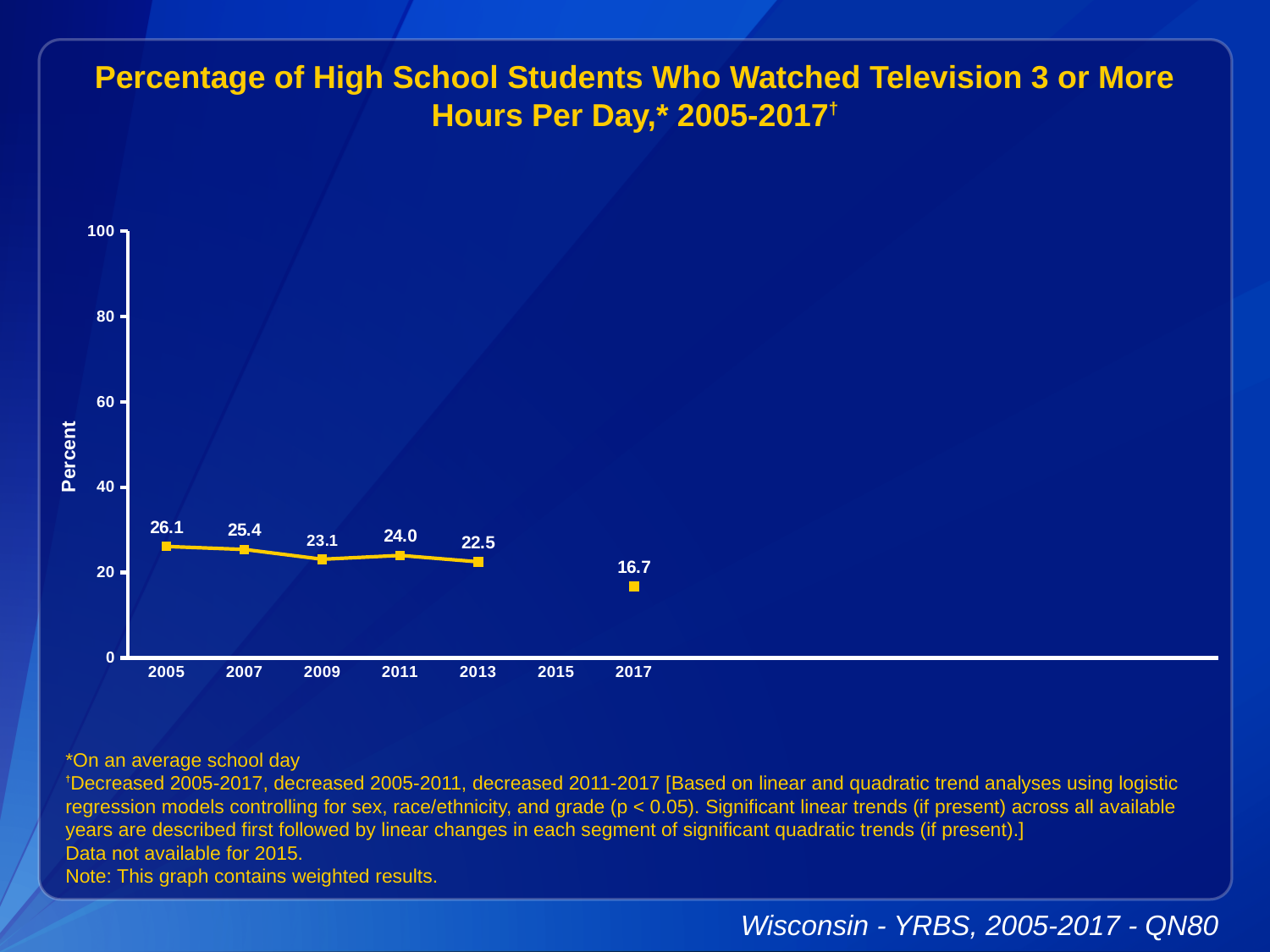
What kind of chart is shown on the slide? line chart What is the difference between the 2005 value and the 2017 value? 9.4 Is the value for 2013 greater or less than 20? greater What is the label on the vertical axis? Percent What is the value plotted for 2011? 24.0 Which is larger, the value for 2009 or the value for 2011? 2011 Do the values generally rise or fall from 2005 to 2017? fall How many years have a data point plotted on the chart? 6 What is the value plotted for 2017? 16.7 What percentage of high school students watched television 3 or more hours per day in 2005? 26.1 Which year has the lowest value on the chart? 2017 Which year has the highest value on the chart? 2005